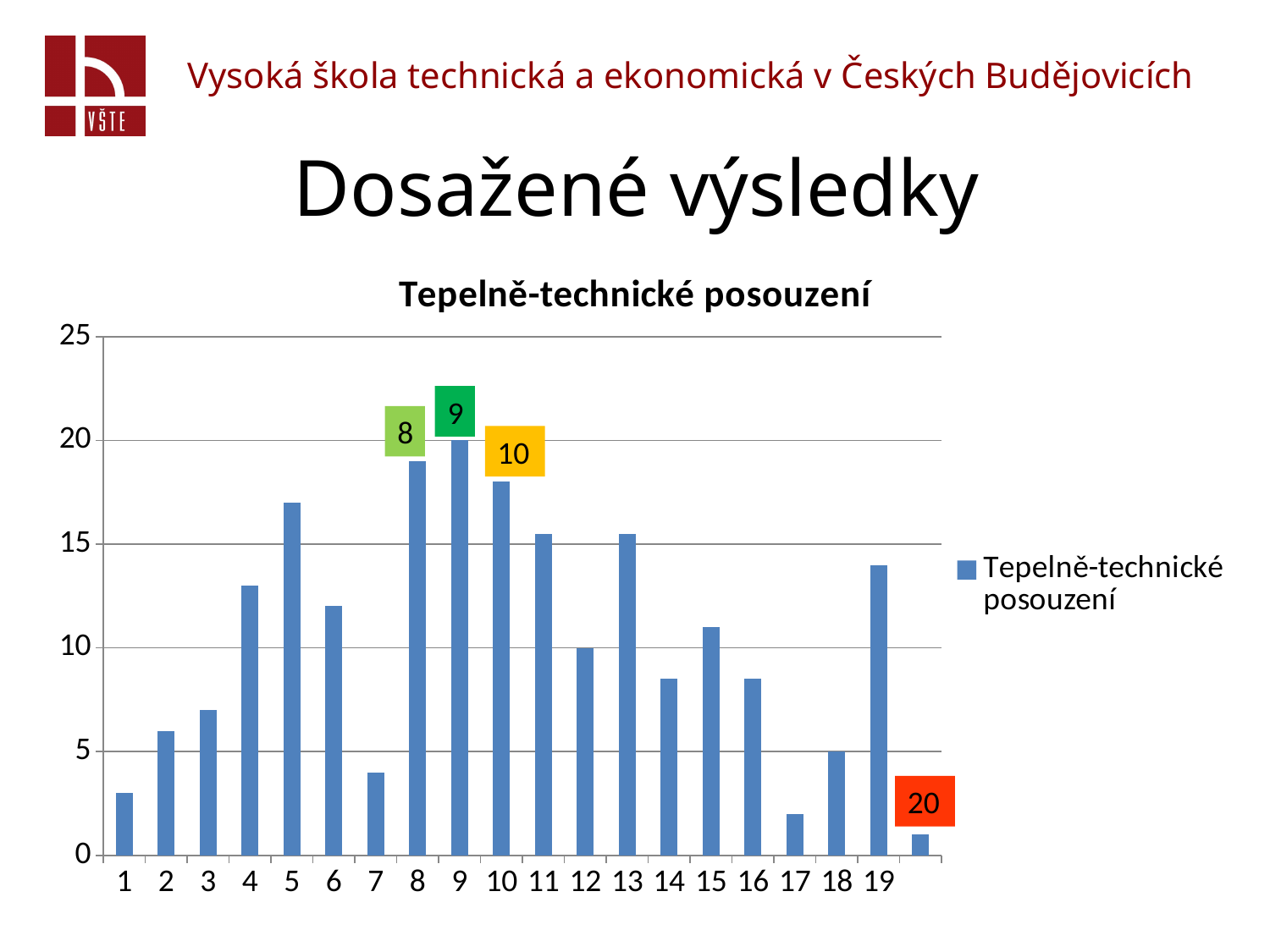
Which is larger, the value for category 5 or the value for category 6? category 5 How many series does the legend list? 1 What is the value for category 9? 20 Which category has the highest bar? 9 What is the value for category 18? 5 Is the value for category 5 greater or less than 15? greater What is the value for category 12? 10 What kind of chart is shown on the slide? bar chart Is the value for category 7 greater or less than 5? less Which is larger, the value for category 14 or the value for category 15? category 15 How many bars are plotted in the chart? 20 What is the title of the chart? Tepelně-technické posouzení